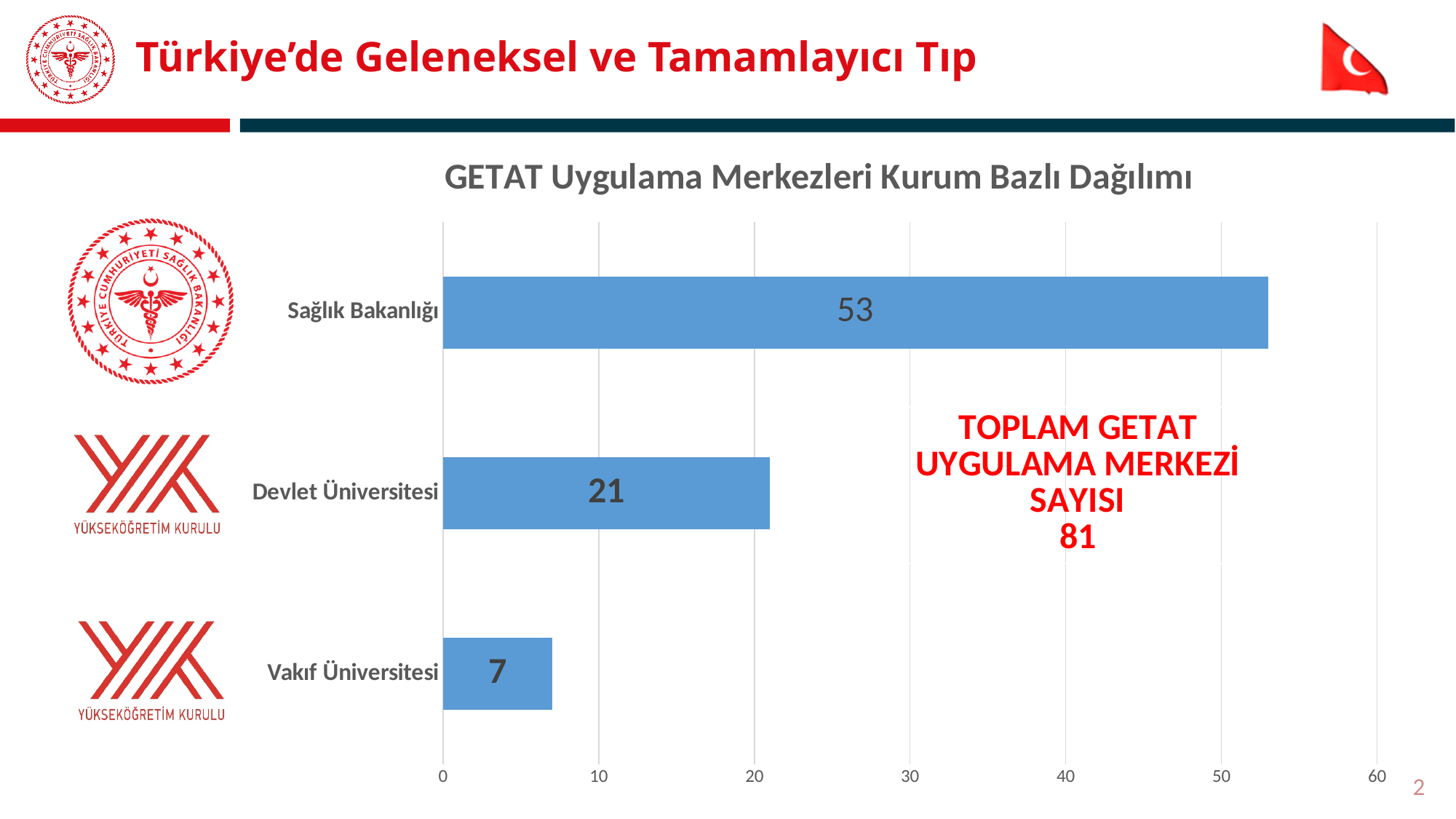
What is the value for Devlet Üniversitesi? 21 How many categories are shown in the chart? 3 What is the value for Vakıf Üniversitesi? 7 What kind of chart is shown on the slide? bar chart What is the difference between the values for Sağlık Bakanlığı and Devlet Üniversitesi? 32 What is the title of the chart? GETAT Uygulama Merkezleri Kurum Bazlı Dağılımı What is the difference between the values for Devlet Üniversitesi and Vakıf Üniversitesi? 14 Which category has the highest value? Sağlık Bakanlığı Which category has the lowest value? Vakıf Üniversitesi Which is larger, the value for Devlet Üniversitesi or Vakıf Üniversitesi? Devlet Üniversitesi Is the value for Sağlık Bakanlığı greater or less than 50? greater What is the value for Sağlık Bakanlığı? 53